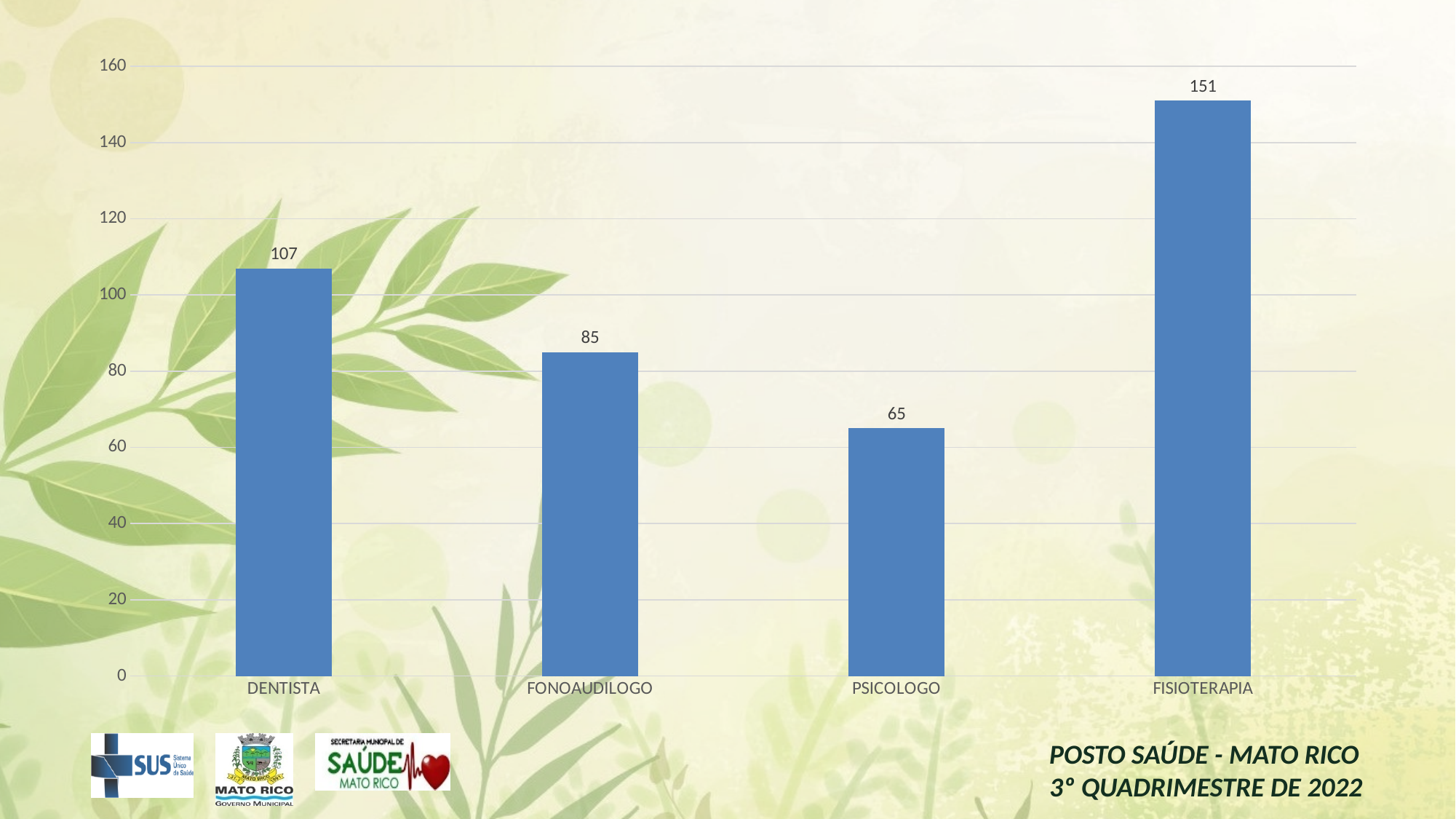
What is the value for FONOAUDILOGO? 85 What is the value for FISIOTERAPIA? 151 What is the value for DENTISTA? 107 Which is larger, the value for DENTISTA or the value for FONOAUDILOGO? DENTISTA What is the value for PSICOLOGO? 65 What is the difference between the values for FISIOTERAPIA and DENTISTA? 44 What is the difference between the values for FONOAUDILOGO and PSICOLOGO? 20 Is the value for FISIOTERAPIA greater or less than 140? greater How many categories are shown on the chart? 4 Which category has the lowest value? PSICOLOGO What kind of chart is shown on the slide? bar chart Which category has the highest value? FISIOTERAPIA